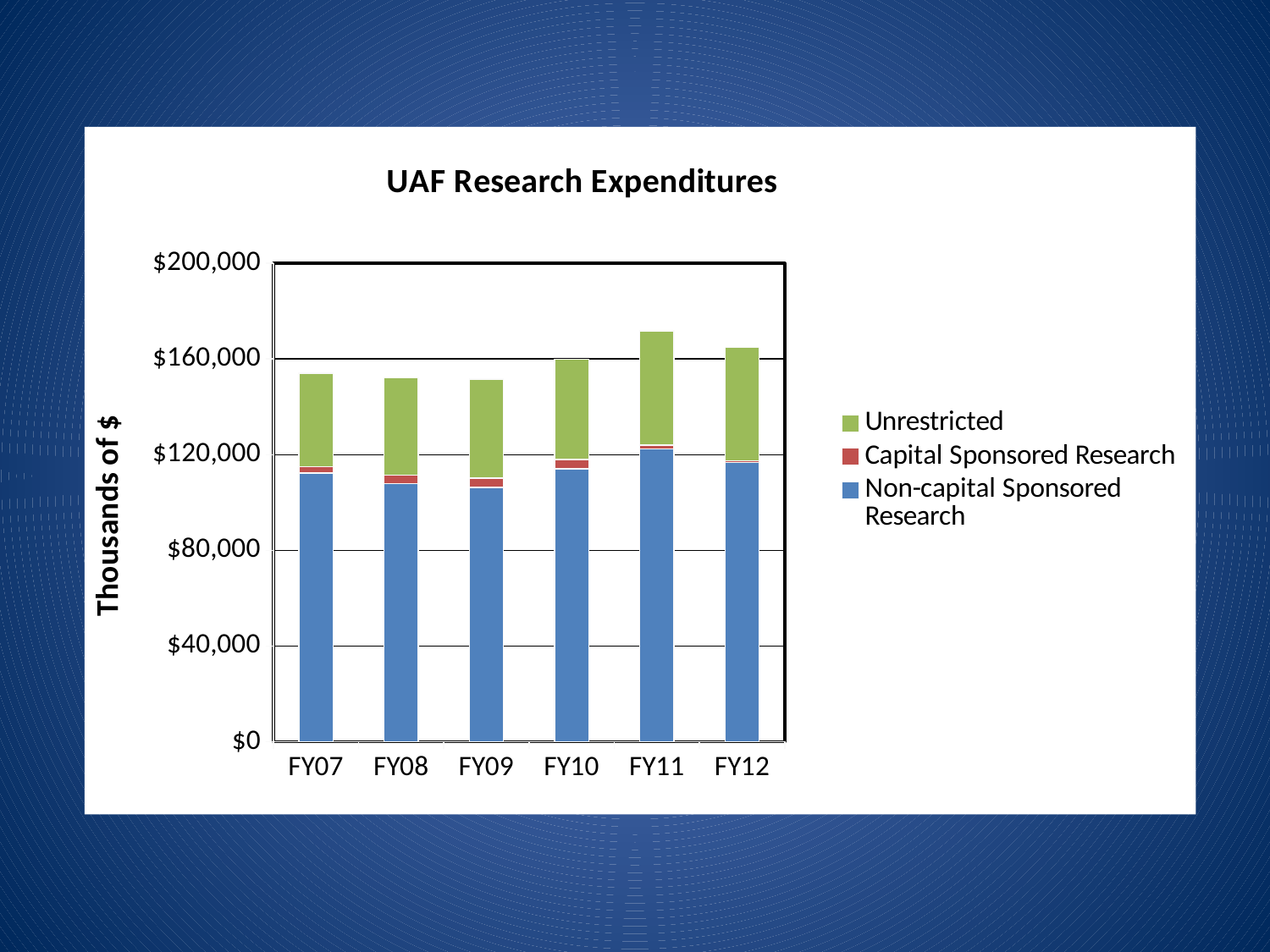
What kind of chart is shown on the slide? stacked bar chart How many fiscal years are shown on the x axis of the UAF Research Expenditures chart? 6 Which has the larger total research expenditure, FY11 or FY08? FY11 Is the total research expenditure for FY07 greater or less than $160,000? less What is the title of the chart? UAF Research Expenditures Which fiscal year has the highest total research expenditures? FY11 How many series does the legend of the UAF Research Expenditures chart list? 3 Is the total research expenditure for FY12 greater or less than $160,000? greater Is the total research expenditure for FY11 greater or less than $160,000? greater What is the label on the vertical axis of the chart? Thousands of $